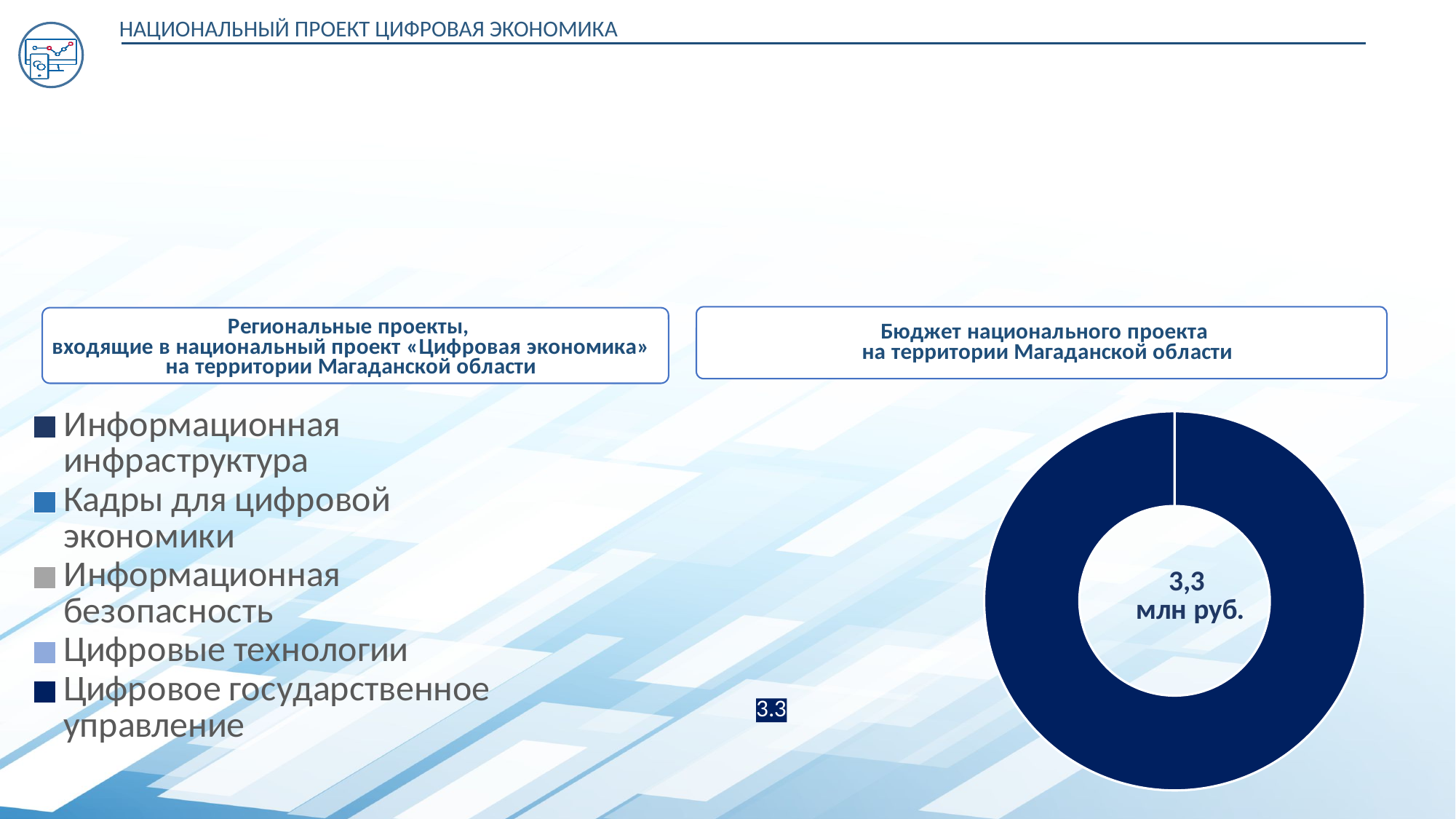
How many distinct slices are visible in the donut chart? 1 What value is printed in the centre of the donut chart? 3,3 млн руб. What kind of chart is shown on the right side of the slide? pie chart (donut) What is the first entry in the chart legend? Информационная инфраструктура What is the title shown above the donut chart? Бюджет национального проекта на территории Магаданской области How many entries does the legend on the left of the slide list? 5 What data label is printed next to the donut chart? 3.3